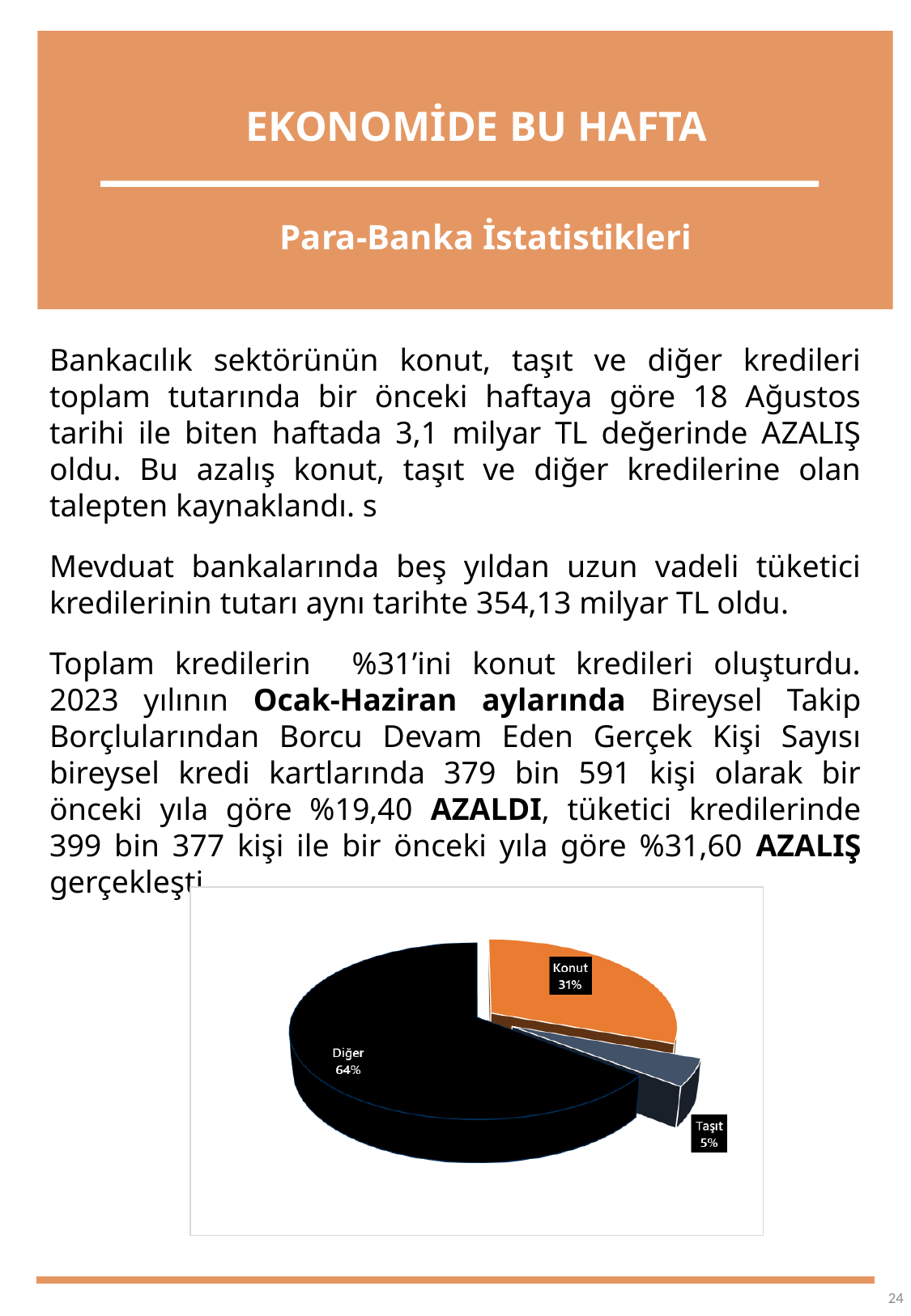
What is the difference in percentage points between the Konut and Taşıt slices? 26 Which category has the largest slice in the pie chart? Diğer What is the difference in percentage points between the Diğer and Konut slices? 33 What share of the pie chart does Konut represent? 31% What share of the pie chart does Taşıt represent? 5% What colour is the Konut slice in the pie chart? Orange What kind of chart is shown on the slide? Pie chart What share of the pie chart does Diğer represent? 64% Which slice is larger, Konut or Taşıt? Konut Which category has the smallest slice in the pie chart? Taşıt How many slices does the pie chart have? 3